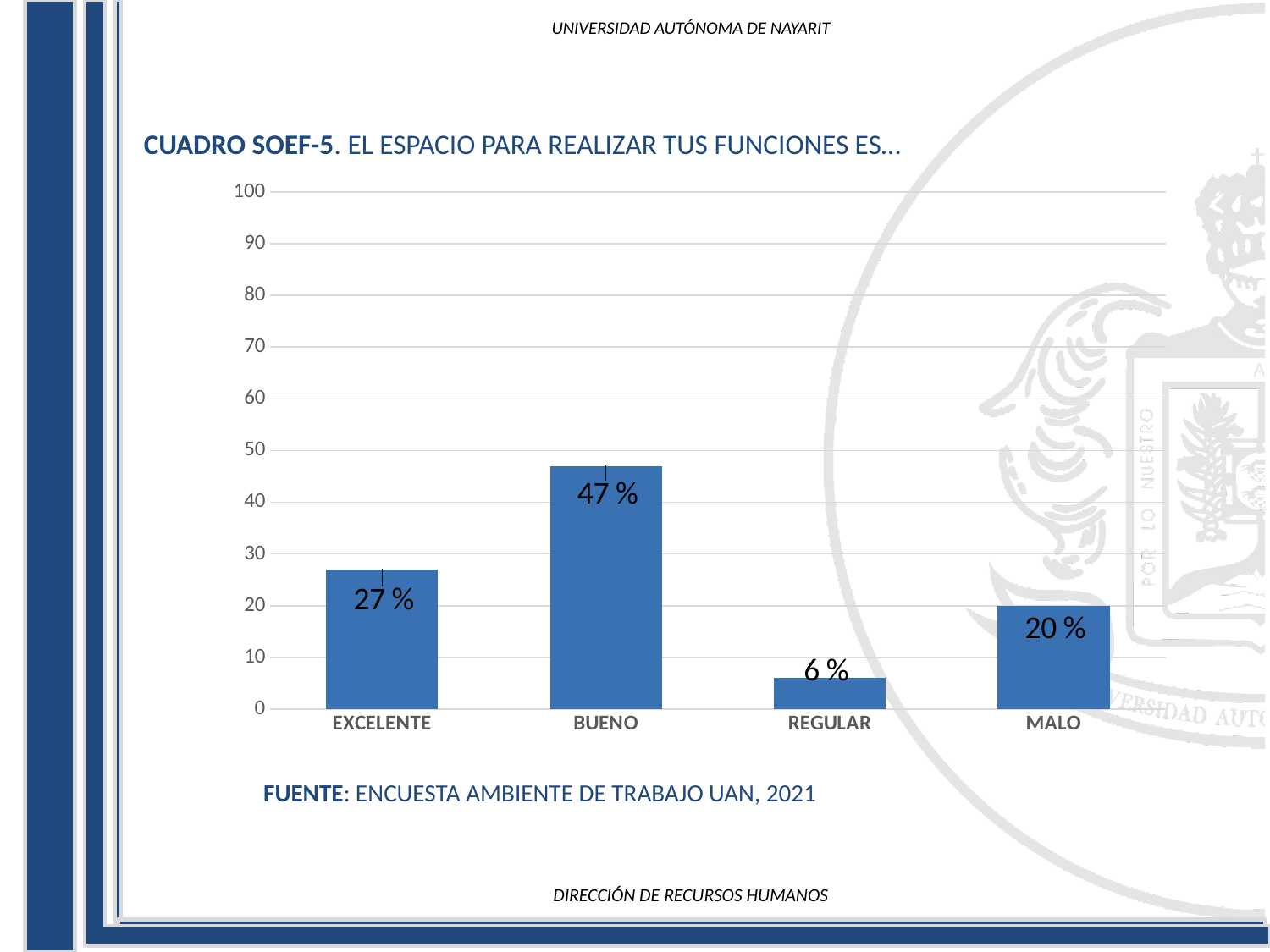
How many categories are shown on the x axis? 4 Which category has the lowest value? REGULAR Which category has the highest value? BUENO What is the value for REGULAR? 6 % What is the source cited below the chart? ENCUESTA AMBIENTE DE TRABAJO UAN, 2021 What is the difference between the values for BUENO and EXCELENTE? 20 % What is the value for BUENO? 47 % Is the value for BUENO greater or less than 50? less What kind of chart is shown on the slide? bar chart What is the value for MALO? 20 % Which is larger, the value for EXCELENTE or the value for MALO? EXCELENTE What is the value for EXCELENTE? 27 %